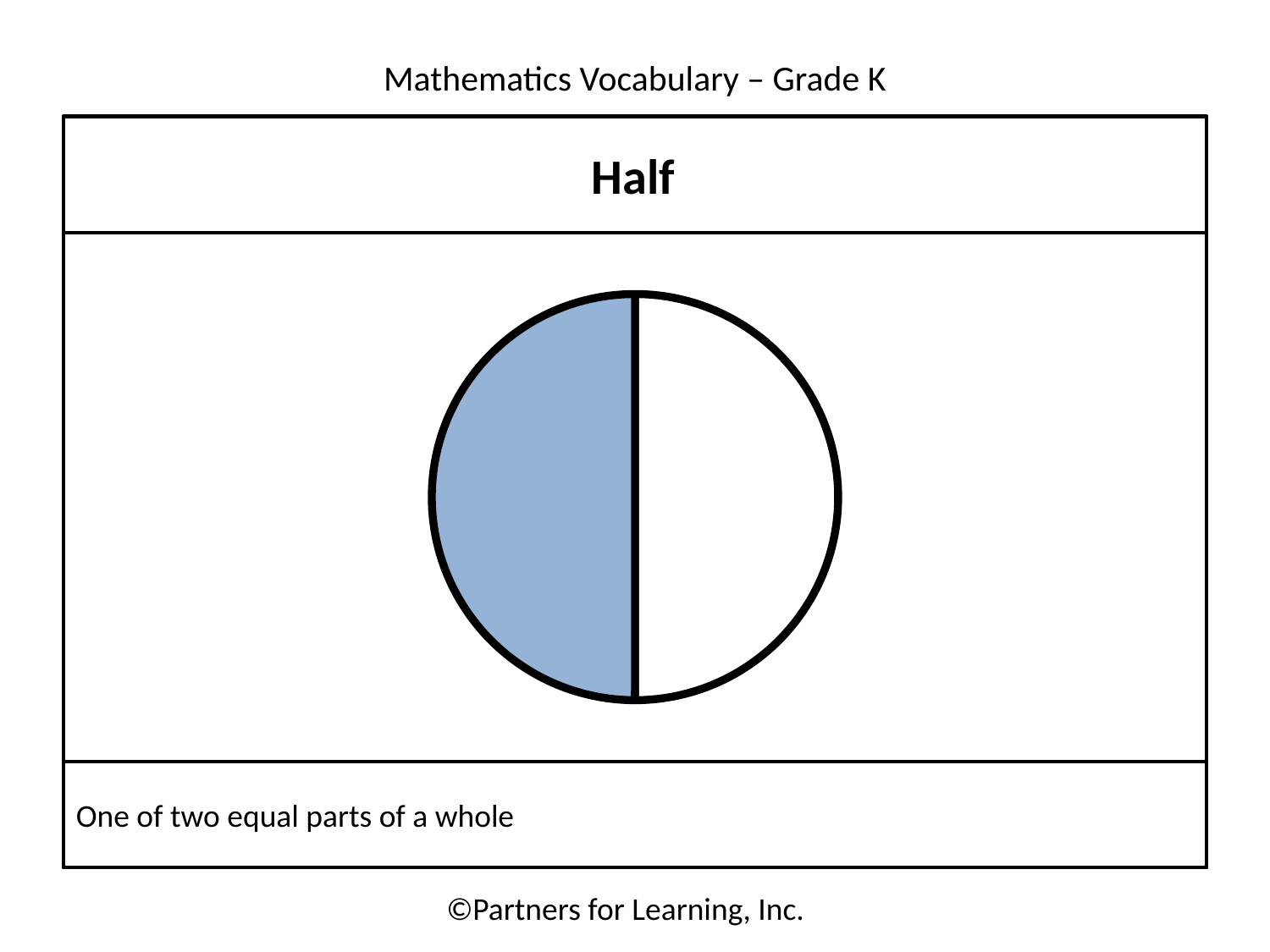
What colour is the shaded part of the circle? Blue What share of the circle is shaded? Half What is the title shown above the circle? Half How many parts is the circle on the slide divided into? 2 Are the two parts of the circle equal or unequal in size? Equal